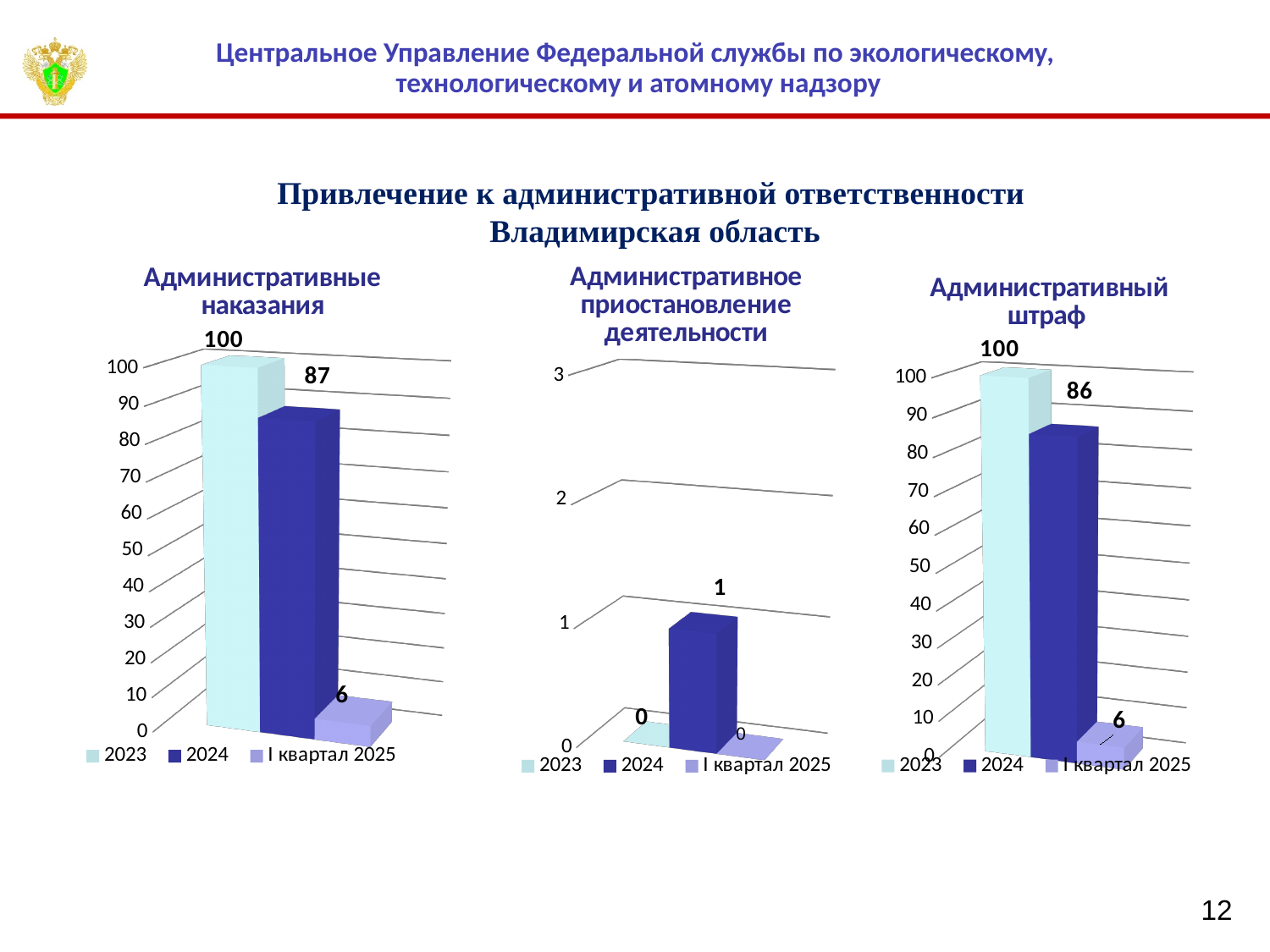
How many series does the legend of the chart titled "Административный штраф" list? 3 In the chart titled "Административное приостановление деятельности", which series has the highest value? 2024 What kind of chart is the chart titled "Административные наказания"? Bar chart In the chart titled "Административный штраф", which series has the lowest value? I квартал 2025 In the chart titled "Административные наказания", which series has the highest value? 2023 In the chart titled "Административные наказания", what is the value for I квартал 2025? 6 In the chart titled "Административное приостановление деятельности", what is the value for 2024? 1 In the chart titled "Административный штраф", what is the difference between the 2024 and I квартал 2025 values? 80 In the chart titled "Административные наказания", what is the difference between the 2023 and 2024 values? 13 In the chart titled "Административное приостановление деятельности", what is the value for 2023? 0 In the chart titled "Административный штраф", what is the value for 2024? 86 In the chart titled "Административные наказания", what is the value for 2024? 87